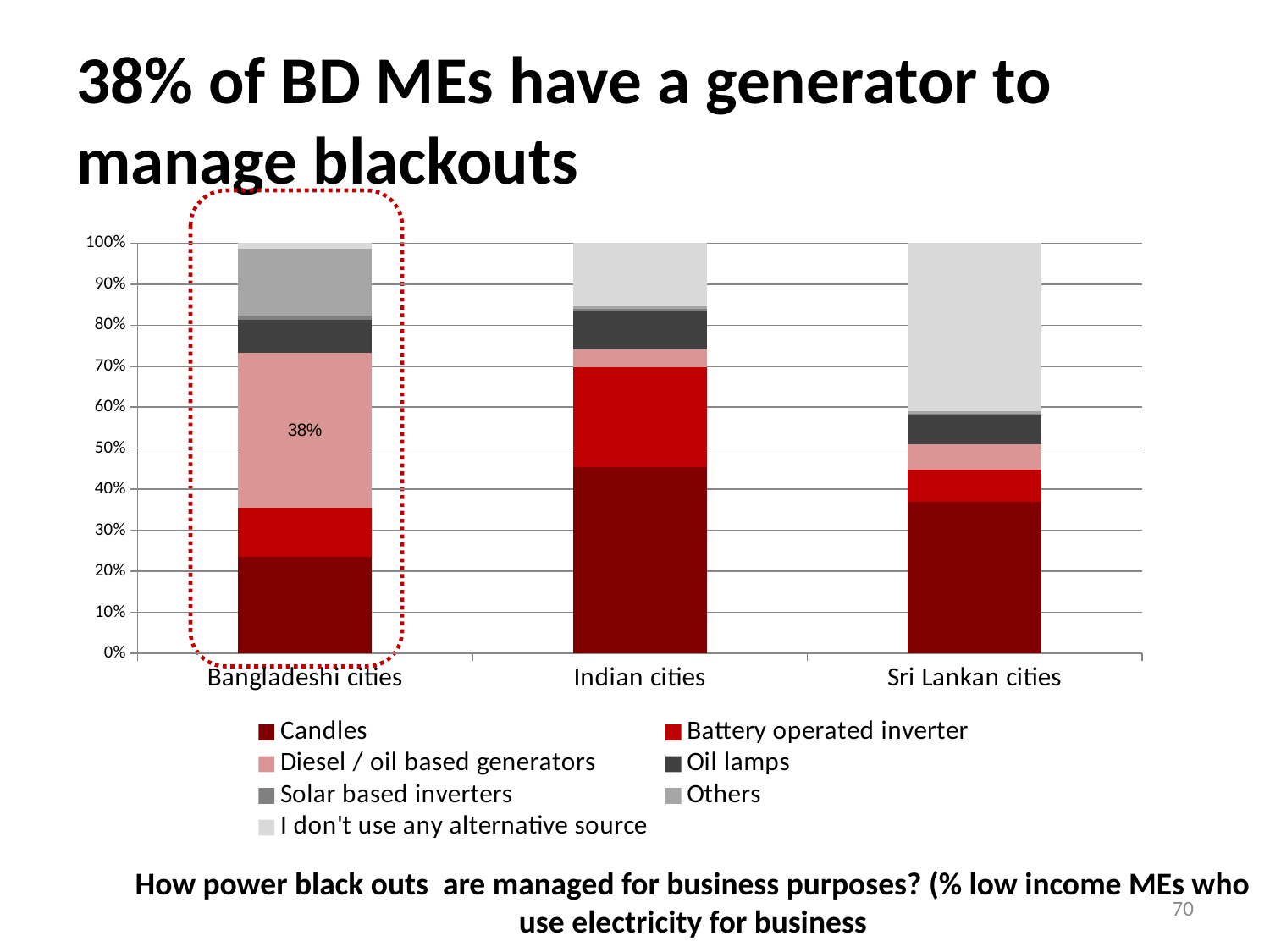
How many series does the chart's legend list? 7 How many city groups are shown on the x axis of the chart? 3 Which has the larger Battery operated inverter segment, Indian cities or Sri Lankan cities? Indian cities Is the Candles share for Bangladeshi cities greater or less than 30%? less Which city group's bar is highlighted with a dashed red outline? Bangladeshi cities What kind of chart is shown on the slide? Stacked bar chart Which has the larger Candles segment, Indian cities or Bangladeshi cities? Indian cities Is the Candles share for Indian cities greater or less than 40%? greater Is the 'I don't use any alternative source' share for Sri Lankan cities greater or less than 30%? greater Which city group has the largest 'I don't use any alternative source' segment? Sri Lankan cities Which city group has the smallest Candles segment? Bangladeshi cities What percentage of Bangladeshi cities MEs use diesel / oil based generators, as labelled on the chart? 38%